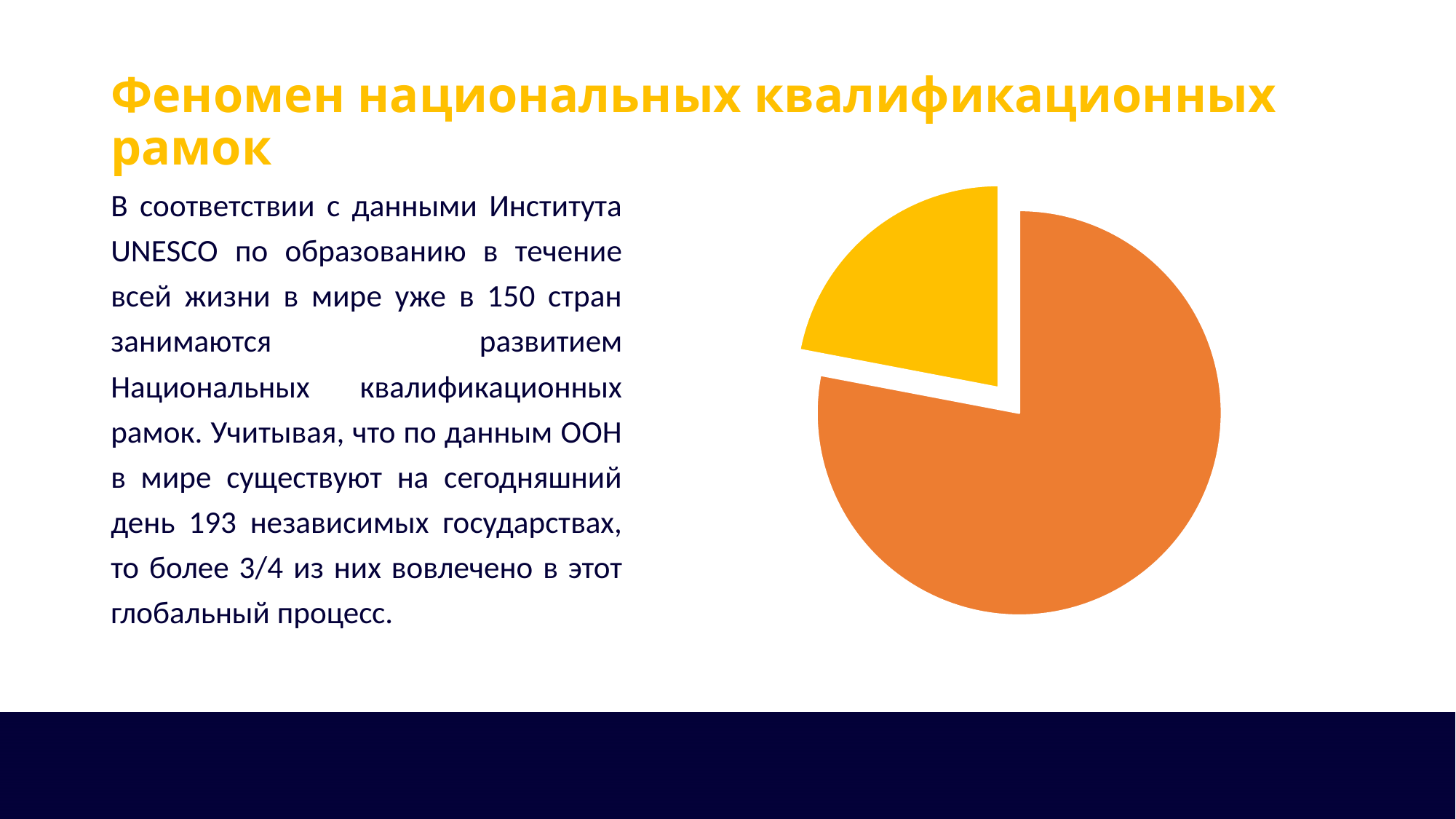
Does the pie chart display a legend? no What kind of chart is shown on the right side of the slide? pie chart Which colour slice takes up the largest share of the pie chart? orange Which slice of the pie chart is pulled out (exploded) from the rest of the pie? the yellow slice Which colour slice takes up the smallest share of the pie chart? yellow Which slice of the pie chart is larger, the orange one or the yellow one? orange How many slices does the pie chart have? 2